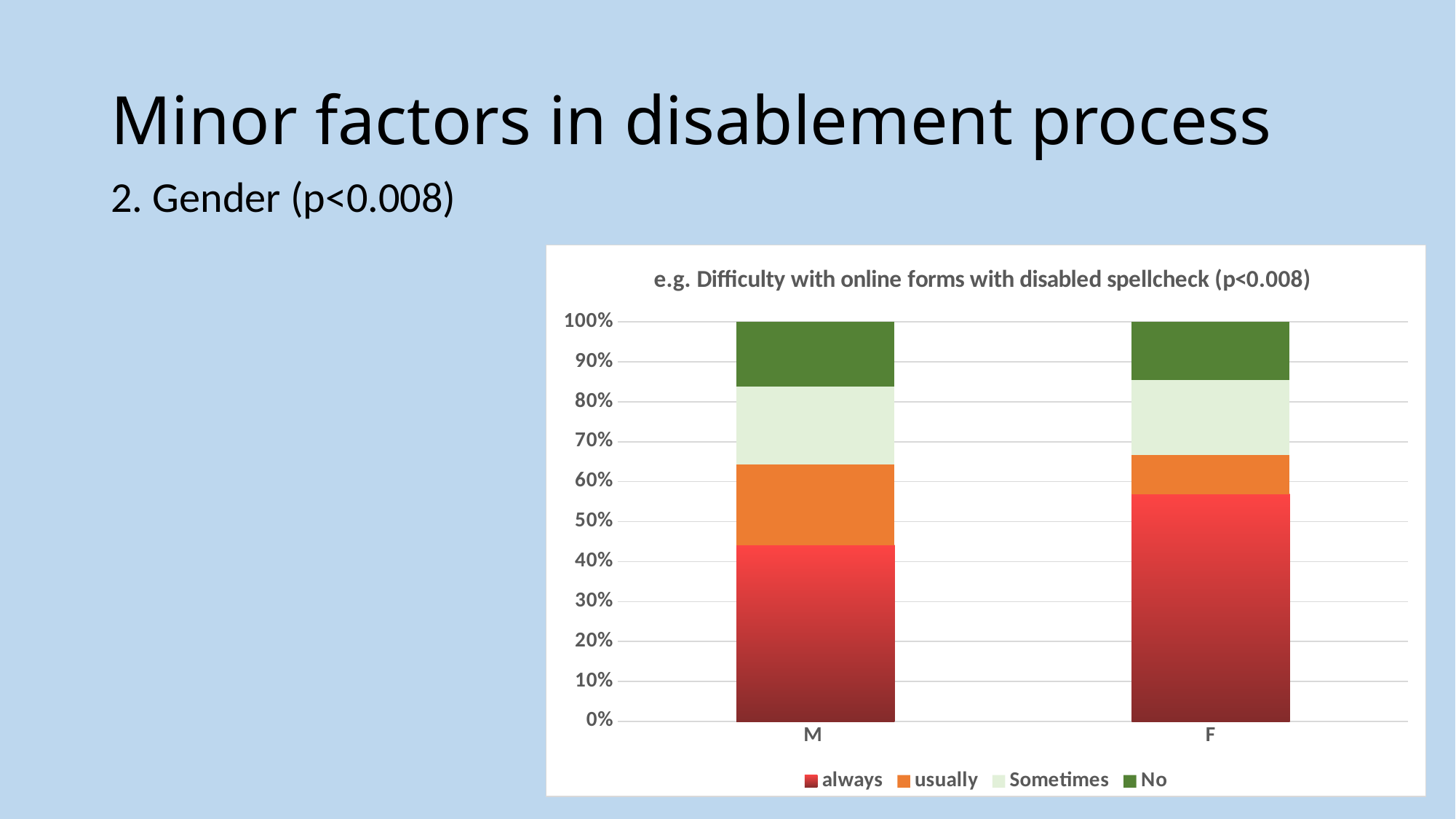
Which category has the larger 'usually' segment, M or F? M How many categories are shown on the x axis of the chart? 2 Is the 'always' value for M greater or less than 40%? greater Which category has the larger 'always' share, M or F? F Is the 'always' value for F greater or less than 50%? greater What kind of chart is shown on the slide? Stacked bar chart What is the title of the chart? e.g. Difficulty with online forms with disabled spellcheck (p<0.008) Which series is shown in red in the chart? always Is the 'always' value for F greater or less than 60%? less What is the total height of the stacked bar for M? 100% How many series does the chart's legend list? 4